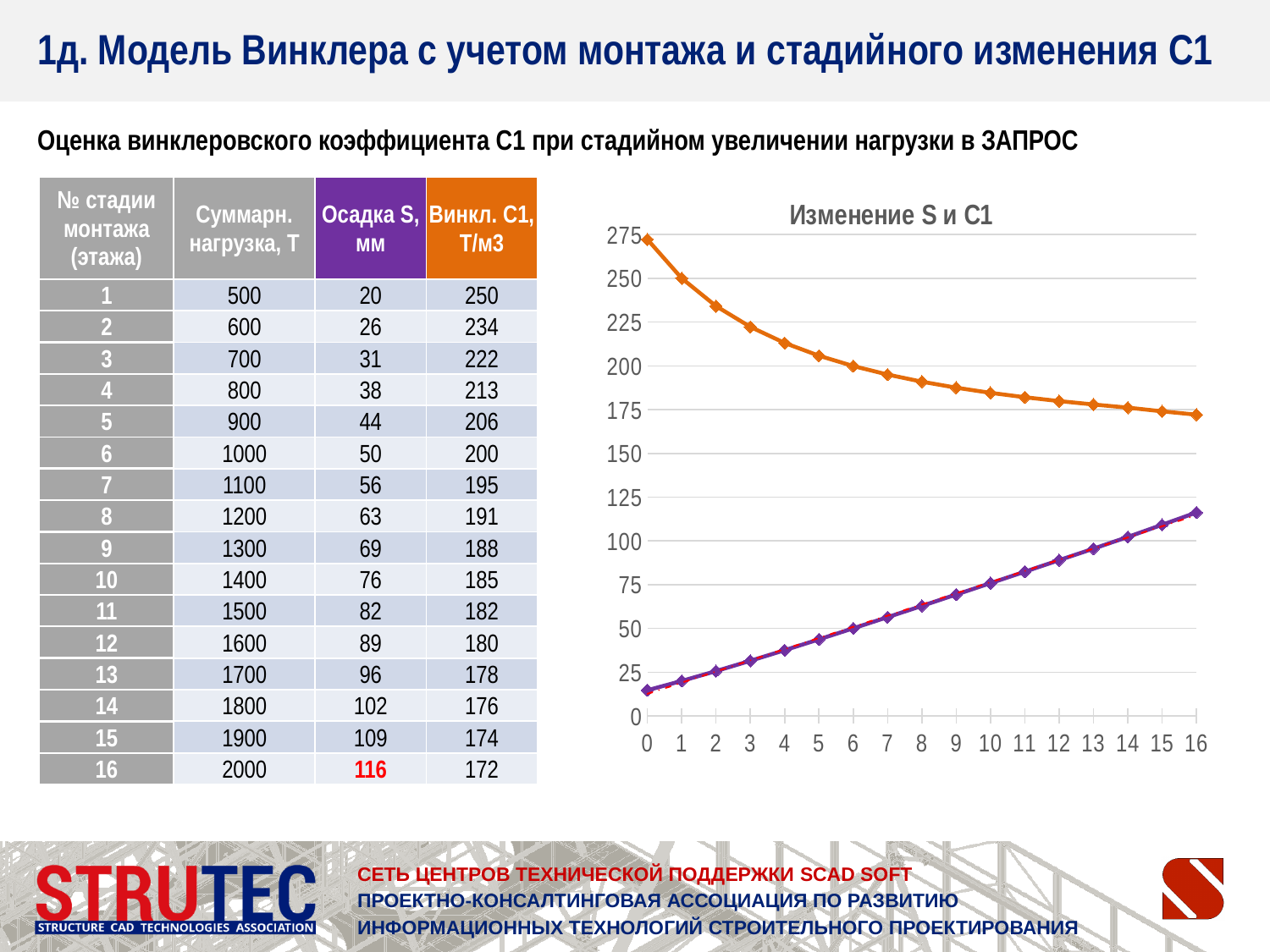
Is the value of the purple line at x = 16 greater or less than 100? greater What is the title of the chart on the slide? Изменение S и C1 Is the value of the orange line at x = 4 greater or less than 200? greater Does the purple line in the chart rise or fall as x increases from 0 to 16? rise What kind of chart is shown on the slide? line chart At x = 16, which line has the larger value in the chart, the orange line or the purple line? orange line At which x value does the orange line in the chart reach its lowest point? 16 Is the value of the orange line at x = 16 greater or less than 175? less At which x value does the orange line in the chart reach its highest point? 0 Does the orange line in the chart rise or fall as x increases from 0 to 16? fall What is the highest tick value shown on the vertical axis of the chart? 275 At which x value does the purple line in the chart reach its highest point? 16